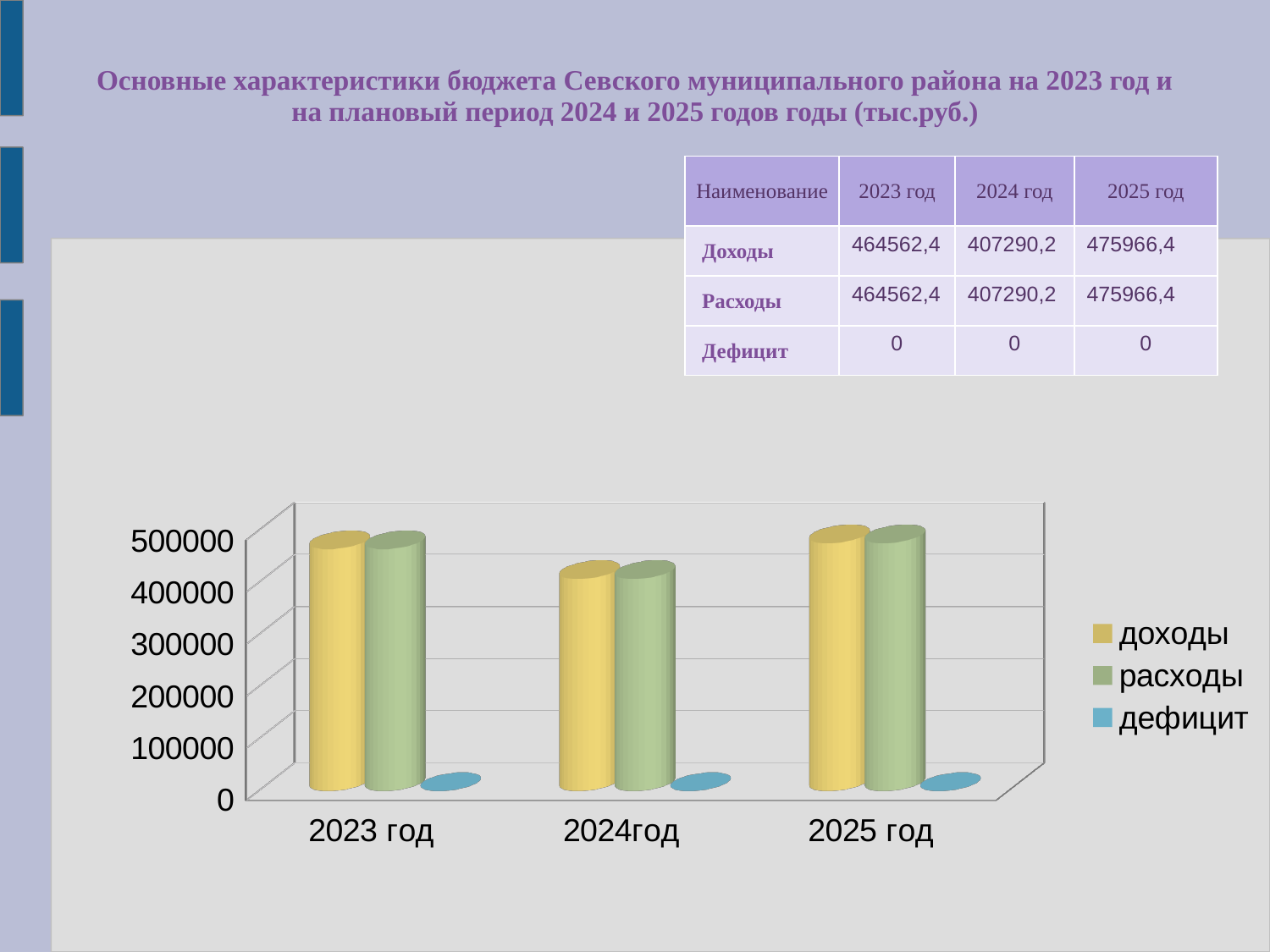
Do доходы rise or fall from 2023 год to 2024 год? fall According to the table on the slide, what is the value of доходы for 2024 год? 407290,2 What kind of chart is shown on the slide? bar chart Is the value of доходы for 2024 год greater or less than 500000? less Is the value of расходы for 2023 год greater or less than 400000? greater In which year are расходы the lowest? 2024 год What is the difference between доходы in 2025 год and доходы in 2024 год? 68676,2 According to the table on the slide, what is the value of расходы for 2025 год? 475966,4 How many series does the chart legend list? 3 How many year categories are shown on the x axis of the chart? 3 What is the value of дефицит in each year? 0 In which year are доходы the highest? 2025 год